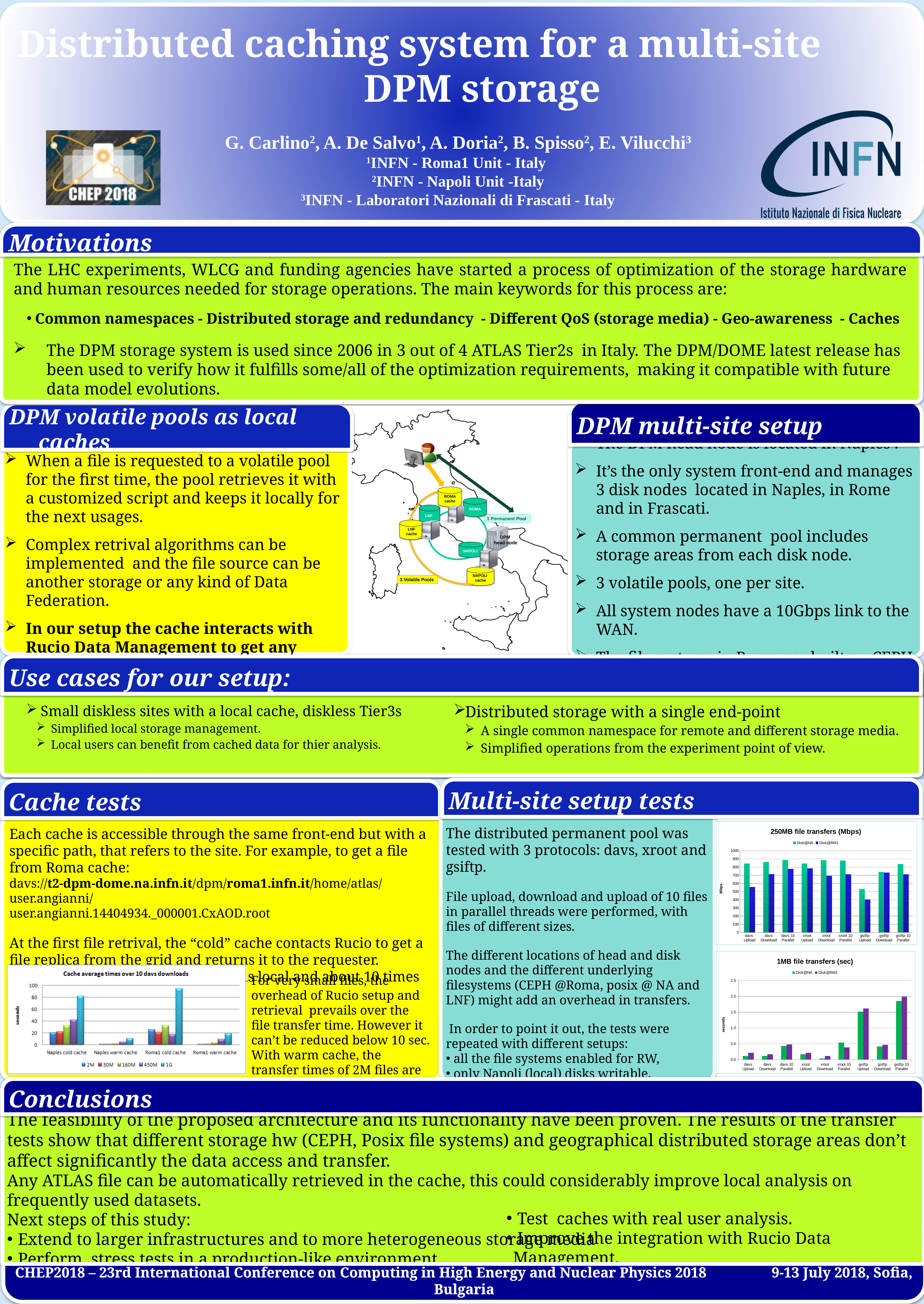
How many categories are shown on the x axis of the 'Cache average times over 10 davs downloads' chart? 4 In the 'Cache average times over 10 davs downloads' chart, is the 1G value for Naples cold cache greater or less than 60 seconds? greater In the '250MB file transfers (Mbps)' chart, which category has the lowest Disk@RM1 value? gsiftp Upload In the 'Cache average times over 10 davs downloads' chart, which category has the highest 1G bar? Roma1 cold cache In the '250MB file transfers (Mbps)' chart, is the Disk@NA value for davs Download greater or less than 800 Mbps? greater In the 'Cache average times over 10 davs downloads' chart, which is larger: the 1G value for Naples cold cache or the 1G value for Naples warm cache? Naples cold cache How many series does the legend of the 'Cache average times over 10 davs downloads' chart list? 5 In the '1MB file transfers (sec)' chart, is the Disk@NA value for gsiftp Upload greater or less than 1.0 seconds? greater How many categories are shown on the x axis of the '250MB file transfers (Mbps)' chart? 9 In the '1MB file transfers (sec)' chart, which category has the highest Disk@RM1 value? gsiftp 10 Parallel What kind of chart is the 'Cache average times over 10 davs downloads' chart? bar chart How many series does the legend of the '250MB file transfers (Mbps)' chart list? 2